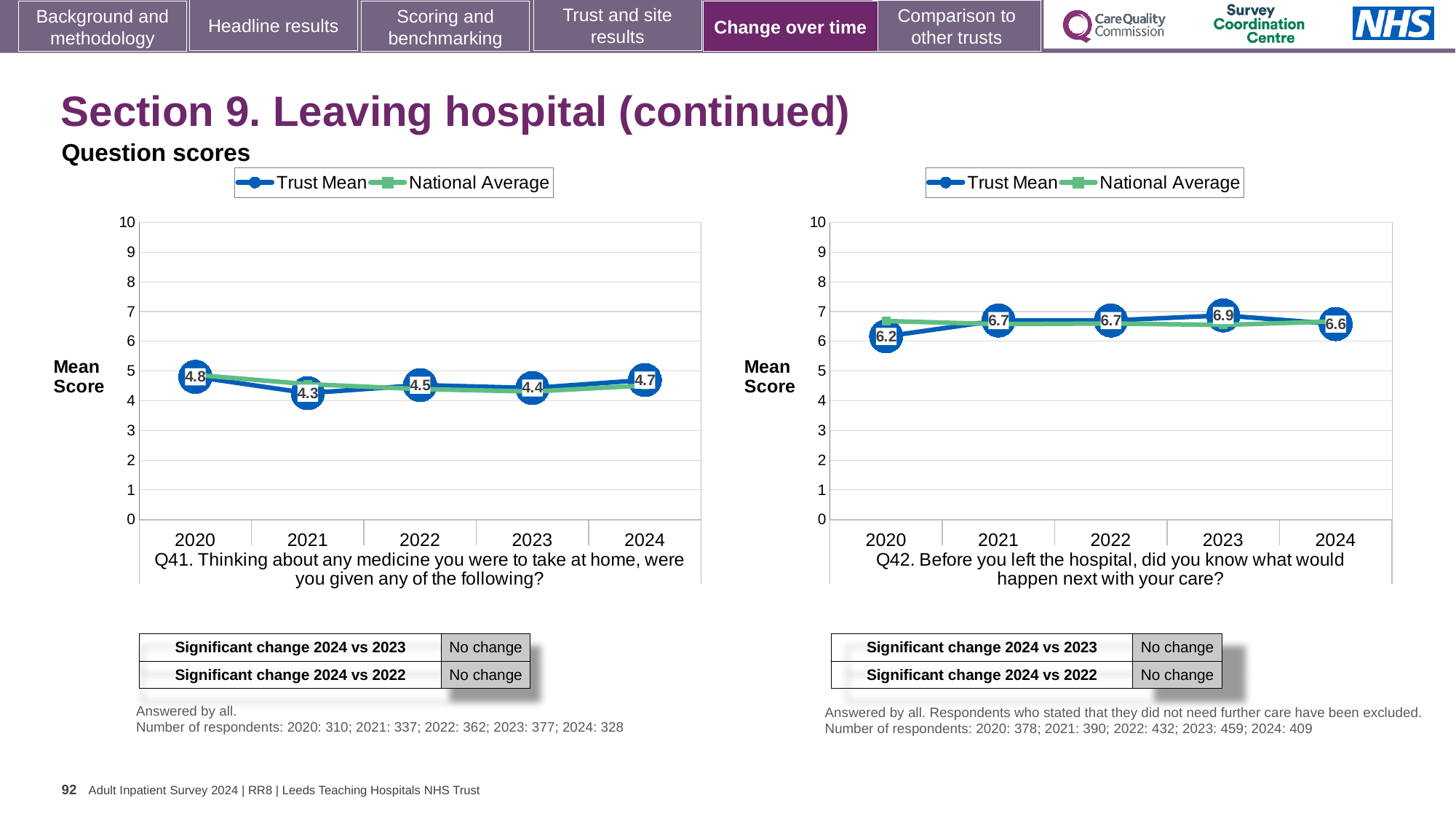
On the Q42 chart (right), what is the Trust Mean score for 2023? 6.9 On the Q41 chart (left), which year has the lowest Trust Mean score? 2021 On the Q42 chart (right), what is the Trust Mean score for 2020? 6.2 How many years are plotted on the Q41 chart (left)? 5 On the Q41 chart (left), what is the Trust Mean score for 2024? 4.7 On the Q42 chart (right), is the Trust Mean score for 2024 higher or lower than for 2023? lower How many series does the legend of the Q42 chart (right) list? 2 On the Q42 chart (right), is the National Average for 2020 greater or less than 5? greater What type of chart is the Q41 chart (left)? Line chart On the Q41 chart (left), what is the difference between the Trust Mean scores for 2020 and 2021? 0.5 On the Q42 chart (right), which year has the highest Trust Mean score? 2023 On the Q41 chart (left), what is the Trust Mean score for 2020? 4.8